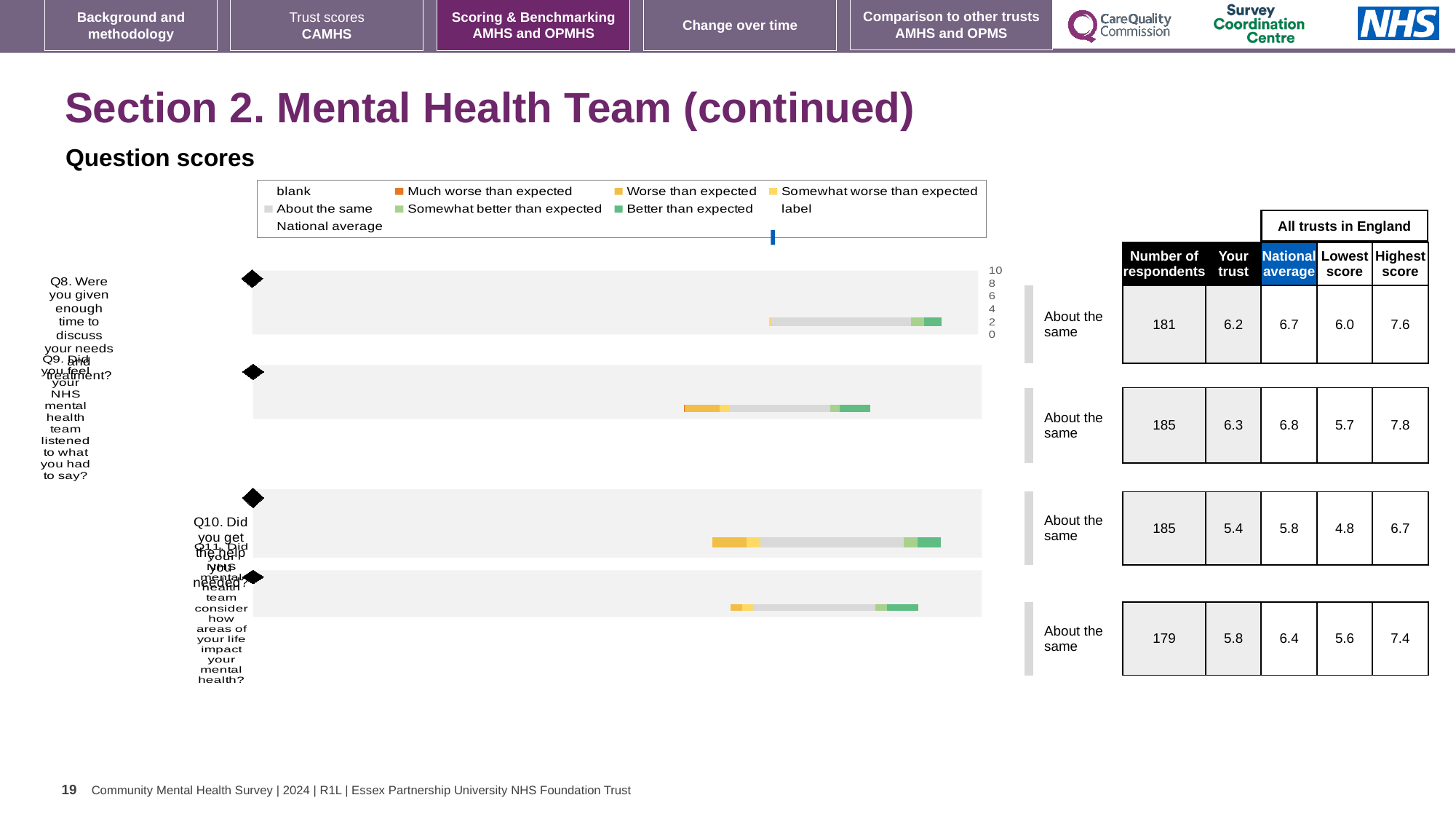
In the table beside the chart, which question has the lowest 'Your trust' score? Q10 What benchmark category is shown for Q9 (Did you feel your NHS mental health team listened to what you had to say?)? About the same What is the highest tick value shown on the score axis of the question scores chart? 10 What kind of chart is used to show the question scores on this slide? bar chart In the table beside the chart, what is the difference between the national average and the 'Your trust' score for Q10? 0.4 In the legend of the question scores chart, what colour represents 'Much worse than expected'? orange How many questions (categories) are plotted in the question scores chart? 4 In the table beside the chart, what is the 'Your trust' score for Q8 (Were you given enough time to discuss your needs and treatment?)? 6.2 In the table beside the chart, which has the larger 'Your trust' score, Q8 or Q11? Q8 In the table beside the chart, what is the number of respondents for Q11 (Did your NHS mental health team consider how areas of your life impact your mental health?)? 179 How many entries does the legend of the question scores chart list? 9 In the table beside the chart, which question has the highest 'Your trust' score? Q9